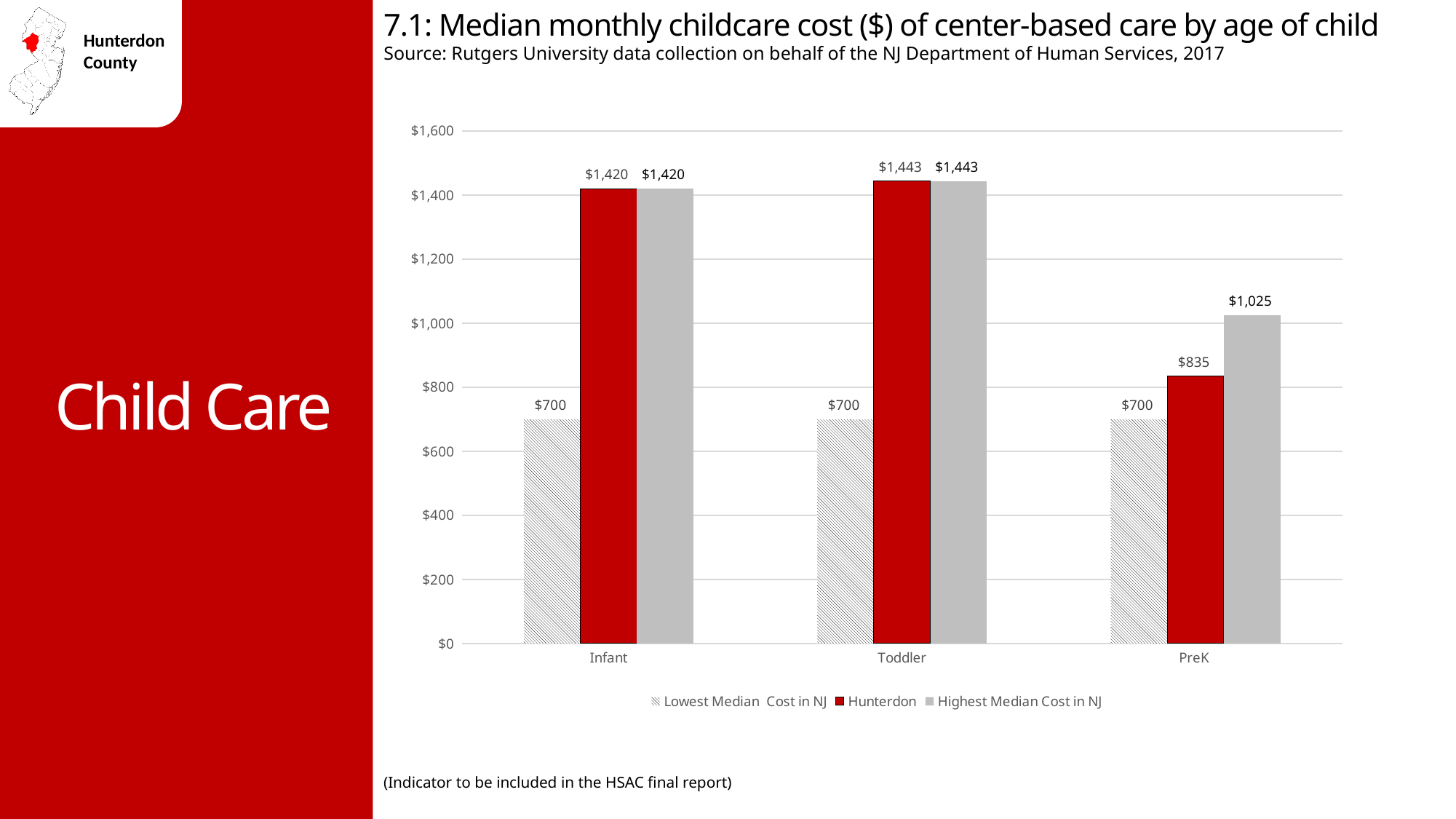
For which age group is the Hunterdon median monthly cost highest? Toddler For which age group is the Hunterdon median monthly cost lowest? PreK What is the Highest Median Cost in NJ for PreK care? $1,025 What is the Hunterdon median monthly cost for PreK care? $835 What is the difference between the Highest Median Cost in NJ and the Hunterdon cost for PreK care? $190 How many age groups are shown on the x axis? 3 What kind of chart is shown on the slide? Bar chart How many series does the legend list? 3 What is the difference between the Hunterdon cost for Toddler care and the Hunterdon cost for Infant care? $23 What is the Hunterdon median monthly childcare cost for Infant care? $1,420 Which is larger, the Hunterdon cost for Infant care or the Hunterdon cost for PreK care? Infant What is the Lowest Median Cost in NJ for Toddler care? $700